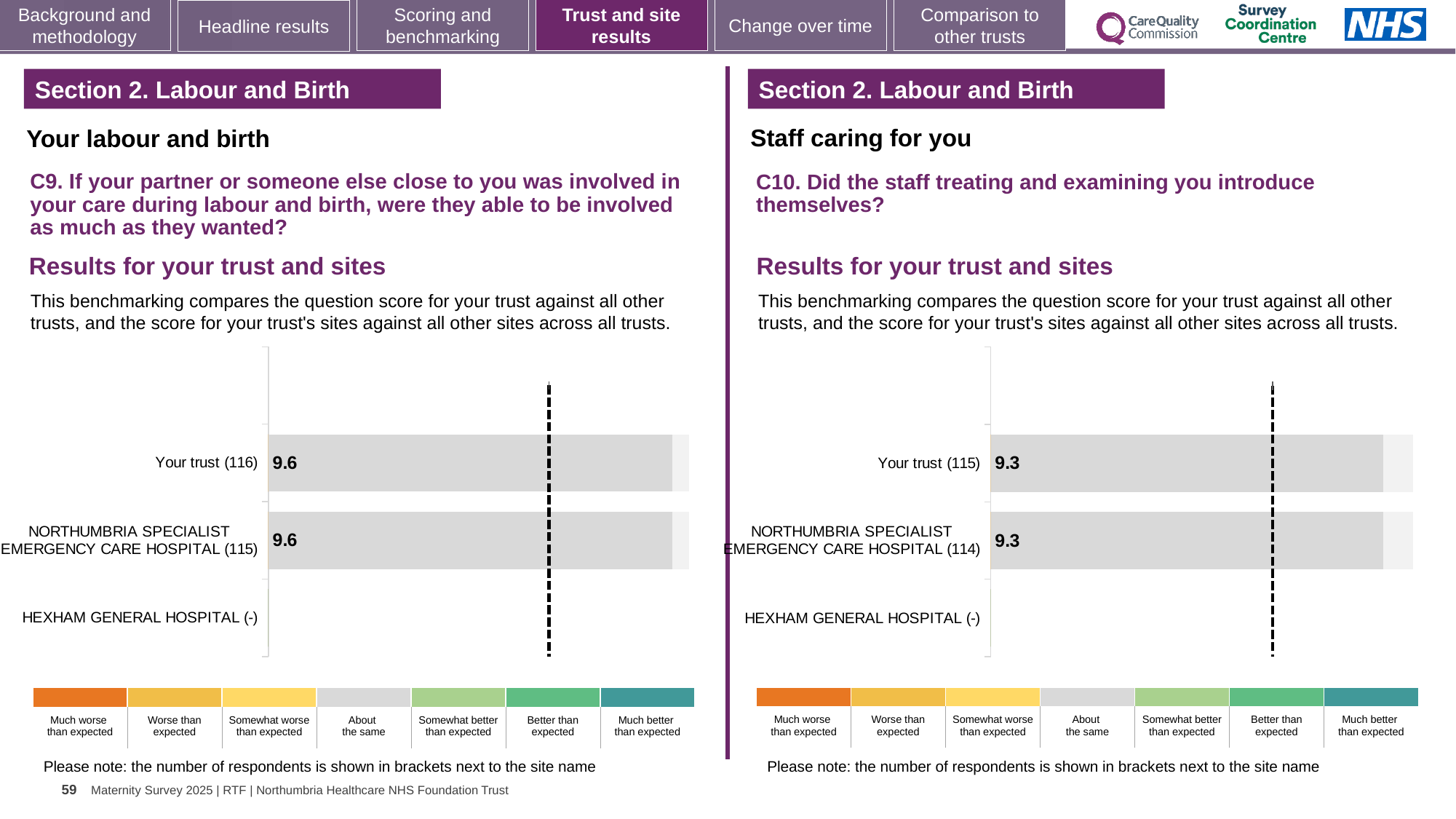
On the right chart (C10), what is the difference between the score for Your trust and the score for NORTHUMBRIA SPECIALIST EMERGENCY CARE HOSPITAL? 0 On the right chart (C10), what is the score for NORTHUMBRIA SPECIALIST EMERGENCY CARE HOSPITAL (114)? 9.3 How many benchmark categories does the colour legend below the left chart (C9) list? 7 On the right chart (C10), what is the score for Your trust (115)? 9.3 On the right chart (C10), how many respondents are shown in brackets for HEXHAM GENERAL HOSPITAL? - On the left chart (C9), what is the difference between the score for Your trust and the score for NORTHUMBRIA SPECIALIST EMERGENCY CARE HOSPITAL? 0 On the left chart (C9), what is the score for Your trust (116)? 9.6 Which chart shows a higher score for Your trust, the left chart (C9) or the right chart (C10)? The left chart (C9) How many site/trust categories are listed on the right chart (C10)? 3 How many site/trust categories are listed on the left chart (C9)? 3 What type of chart is used on the left (C9) to show the results for your trust and sites? Bar chart On the left chart (C9), what is the score for NORTHUMBRIA SPECIALIST EMERGENCY CARE HOSPITAL (115)? 9.6